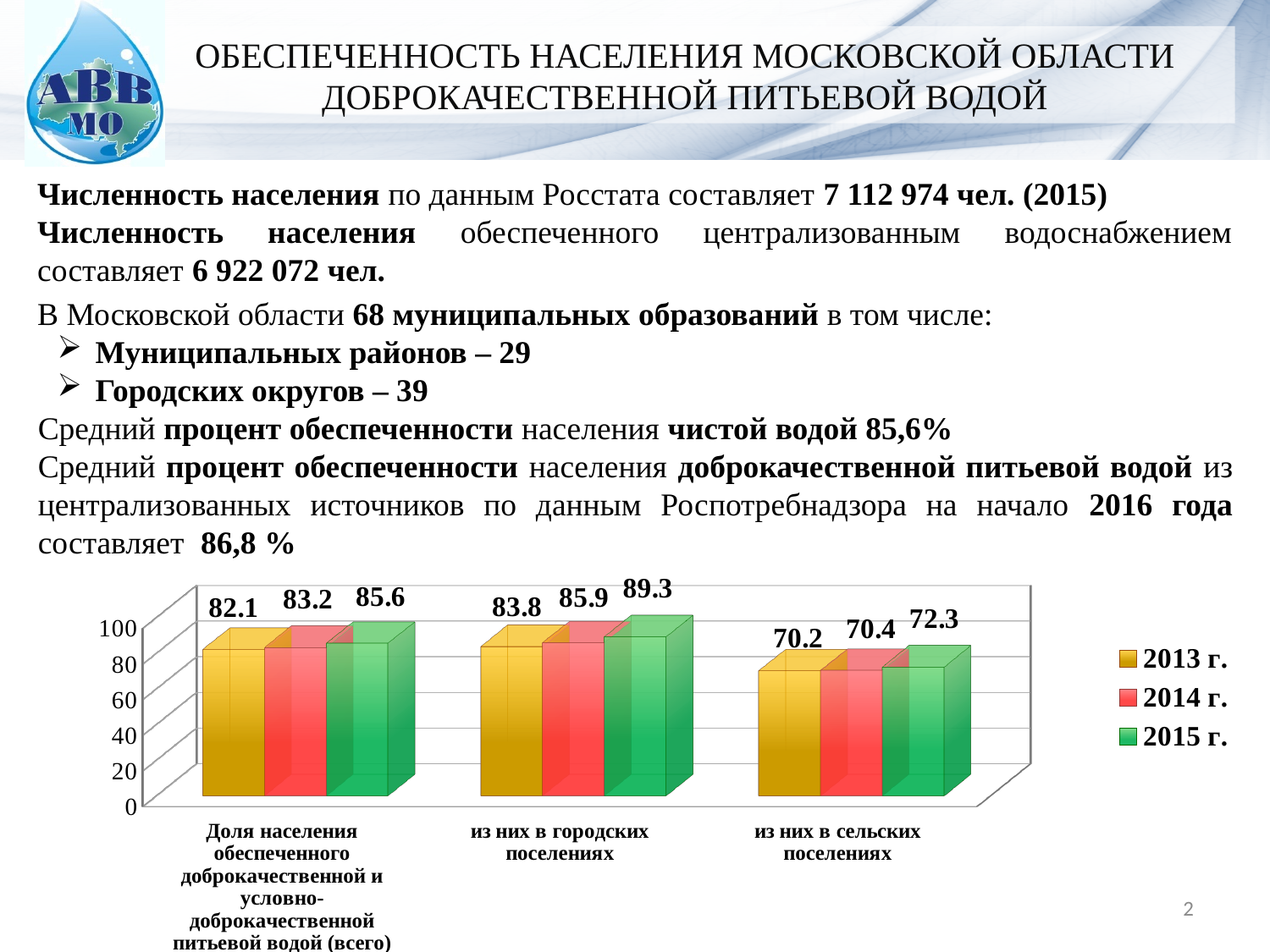
What is the difference between the 2015 г. and 2013 г. values in the category "из них в городских поселениях"? 5.5 Which category has the lowest value for 2013 г.? из них в сельских поселениях Within the category "из них в сельских поселениях", do the values rise or fall from 2013 г. to 2015 г.? rise Which category has the highest value for 2015 г.? из них в городских поселениях What is the value for 2015 г. in the category "из них в городских поселениях"? 89.3 Which is larger: the 2015 г. value for "из них в сельских поселениях" or the 2013 г. value for "из них в городских поселениях"? 2013 г. value for "из них в городских поселениях" What is the value for 2013 г. in the category "из них в сельских поселениях"? 70.2 Is the value for 2014 г. in "из них в сельских поселениях" greater or less than 80? less What kind of chart is shown on the slide? bar chart How many series does the chart legend list? 3 What is the value for 2014 г. in the category "Доля населения обеспеченного доброкачественной и условно-доброкачественной питьевой водой (всего)"? 83.2 How many categories are shown on the x axis of the chart? 3